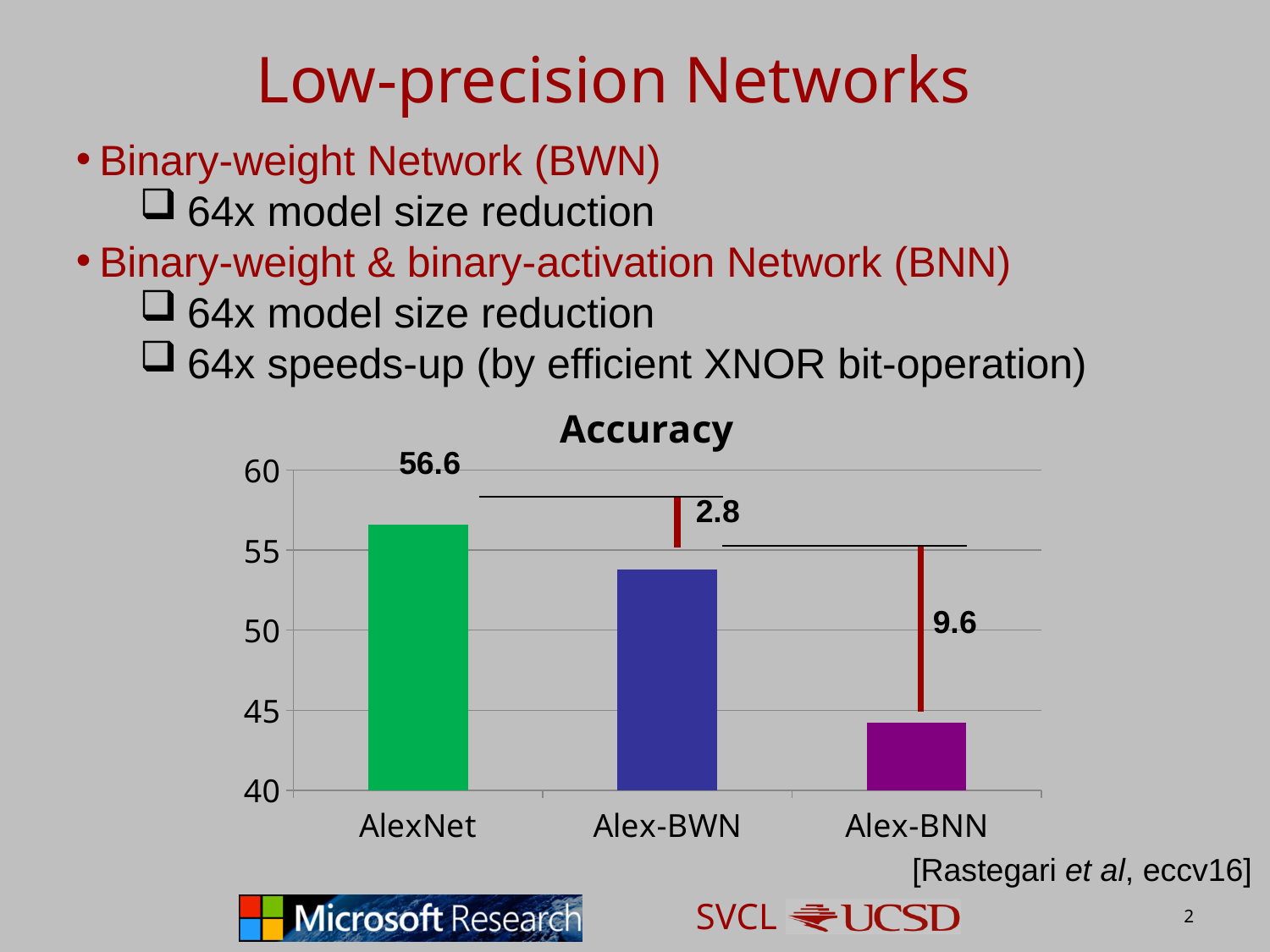
Which category has the highest accuracy? AlexNet What number is annotated next to the short red line between the AlexNet and Alex-BWN bars? 2.8 What is the accuracy value labeled for AlexNet? 56.6 Which has a higher accuracy, Alex-BWN or Alex-BNN? Alex-BWN Is the value for Alex-BNN greater or less than 50? less Do the accuracy values rise or fall from left to right across the categories? fall How many bars (categories) are shown in the Accuracy chart? 3 What is the title of the chart? Accuracy What type of chart is shown on the slide? bar chart Is the value for Alex-BWN greater or less than 50? greater Which category has the lowest accuracy? Alex-BNN What colour is the AlexNet bar? green